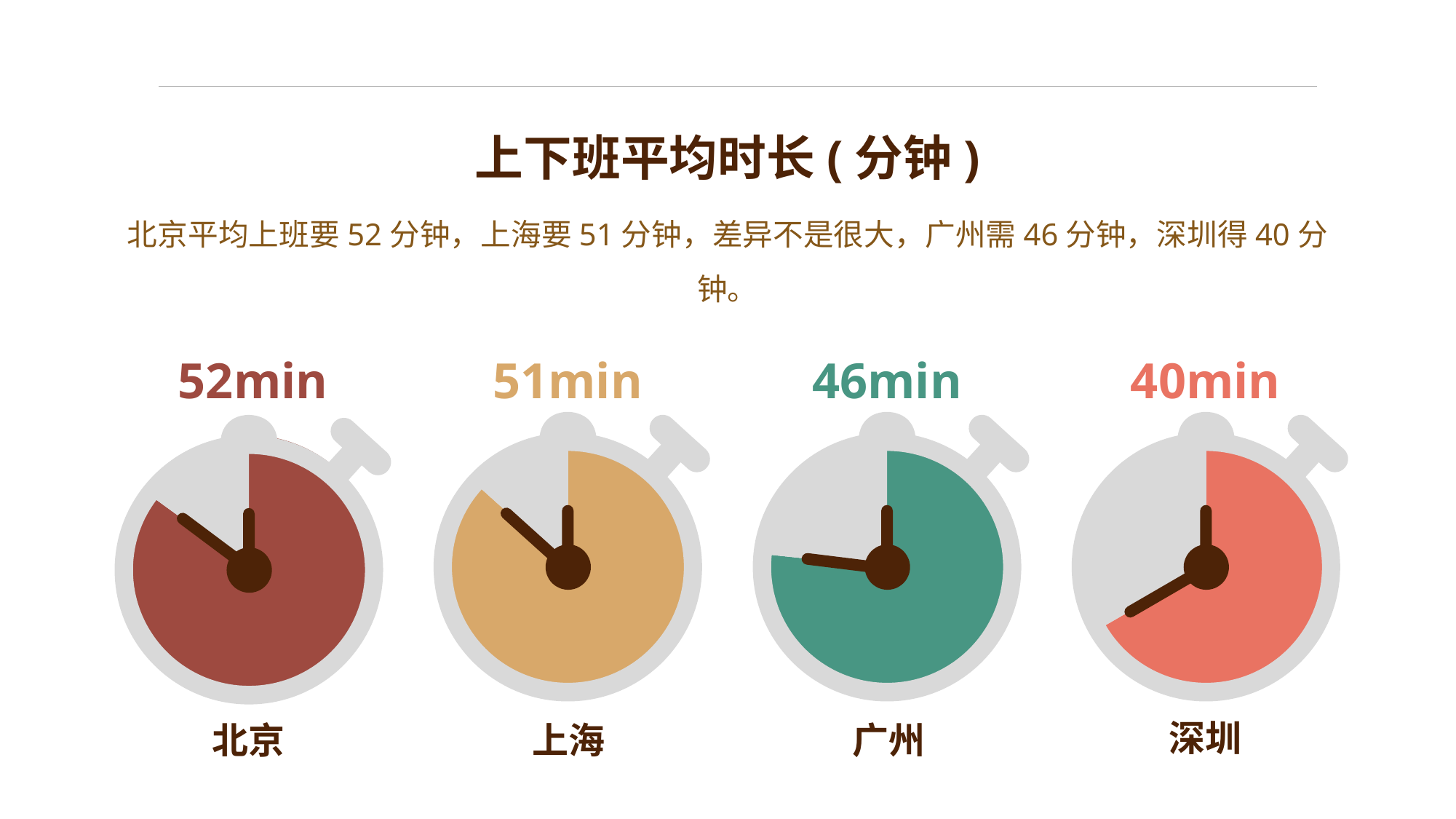
How many cities are shown on the slide? 4 What is the title of the chart on the slide? 上下班平均时长 ( 分钟 ) What is the average commute time shown for 北京? 52min What is the average commute time shown for 深圳? 40min Which city has the shortest average commute time? 深圳 Which city has the longest average commute time? 北京 What is the average commute time shown for 上海? 51min What is the difference in average commute time between 广州 and 深圳? 6min Do the commute times rise or fall from left to right across the cities? fall What is the average commute time shown for 广州? 46min What is the difference in average commute time between 北京 and 深圳? 12min Which city has a longer average commute time, 上海 or 广州? 上海